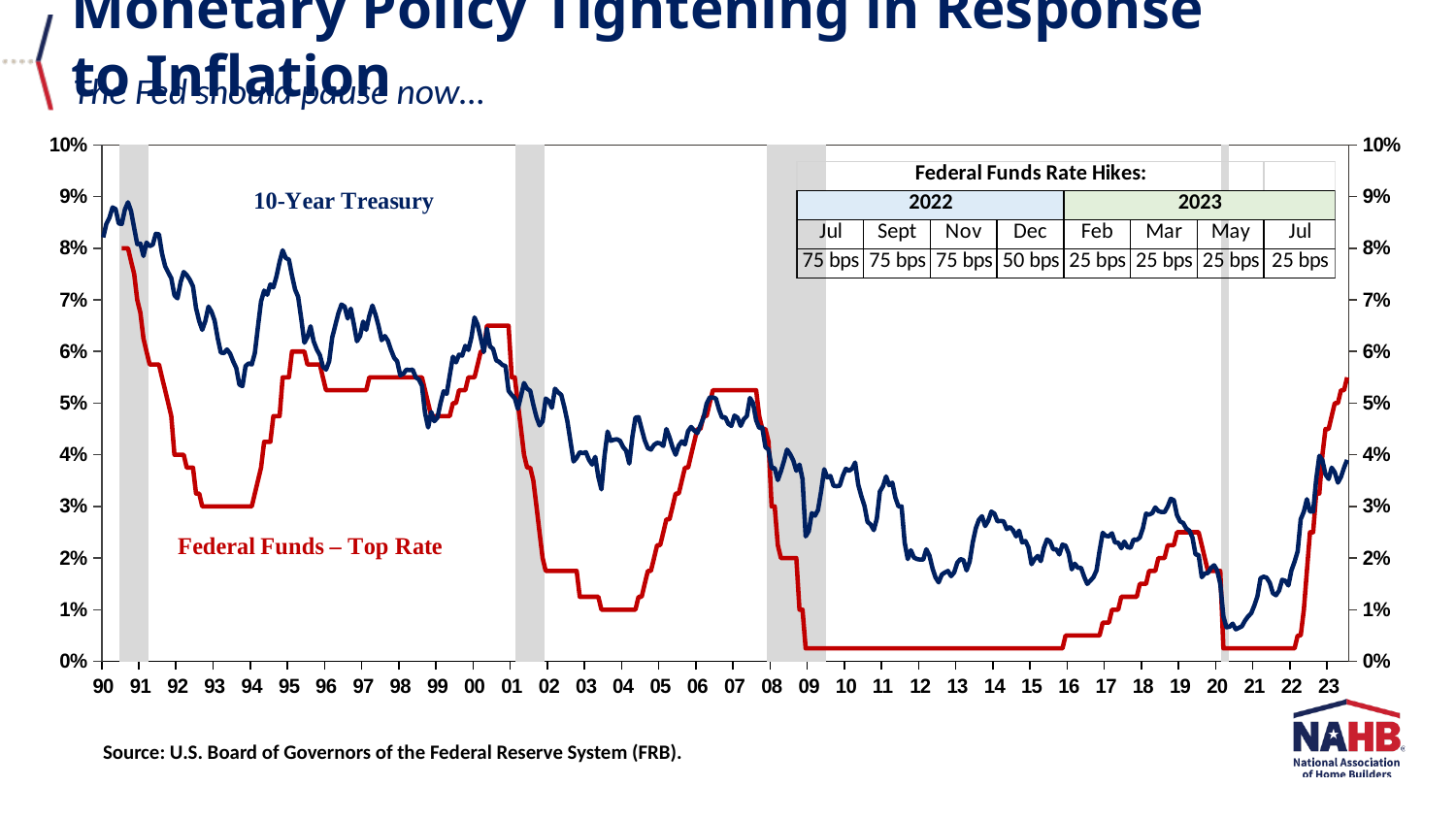
Is the Federal Funds – Top Rate in 2010 greater or less than 1%? less According to the Federal Funds Rate Hikes table, how large was the hike in March 2023? 25 bps Is the 10-Year Treasury rate at the start of 1990 greater or less than 8%? greater What kind of chart is shown on the slide? Line chart In 2010, which series is higher: the 10-Year Treasury or the Federal Funds – Top Rate? 10-Year Treasury How many data series are plotted on the chart? 2 What is the difference between the July 2022 hike and the July 2023 hike in the Federal Funds Rate Hikes table? 50 bps According to the Federal Funds Rate Hikes table, how large was the hike in July 2022? 75 bps What are the names of the two series plotted on the chart? 10-Year Treasury and Federal Funds – Top Rate What is the source cited for the chart data? U.S. Board of Governors of the Federal Reserve System (FRB) Overall, does the 10-Year Treasury rate rise or fall from 1990 to 2020? Fall According to the Federal Funds Rate Hikes table, how large was the hike in December 2022? 50 bps